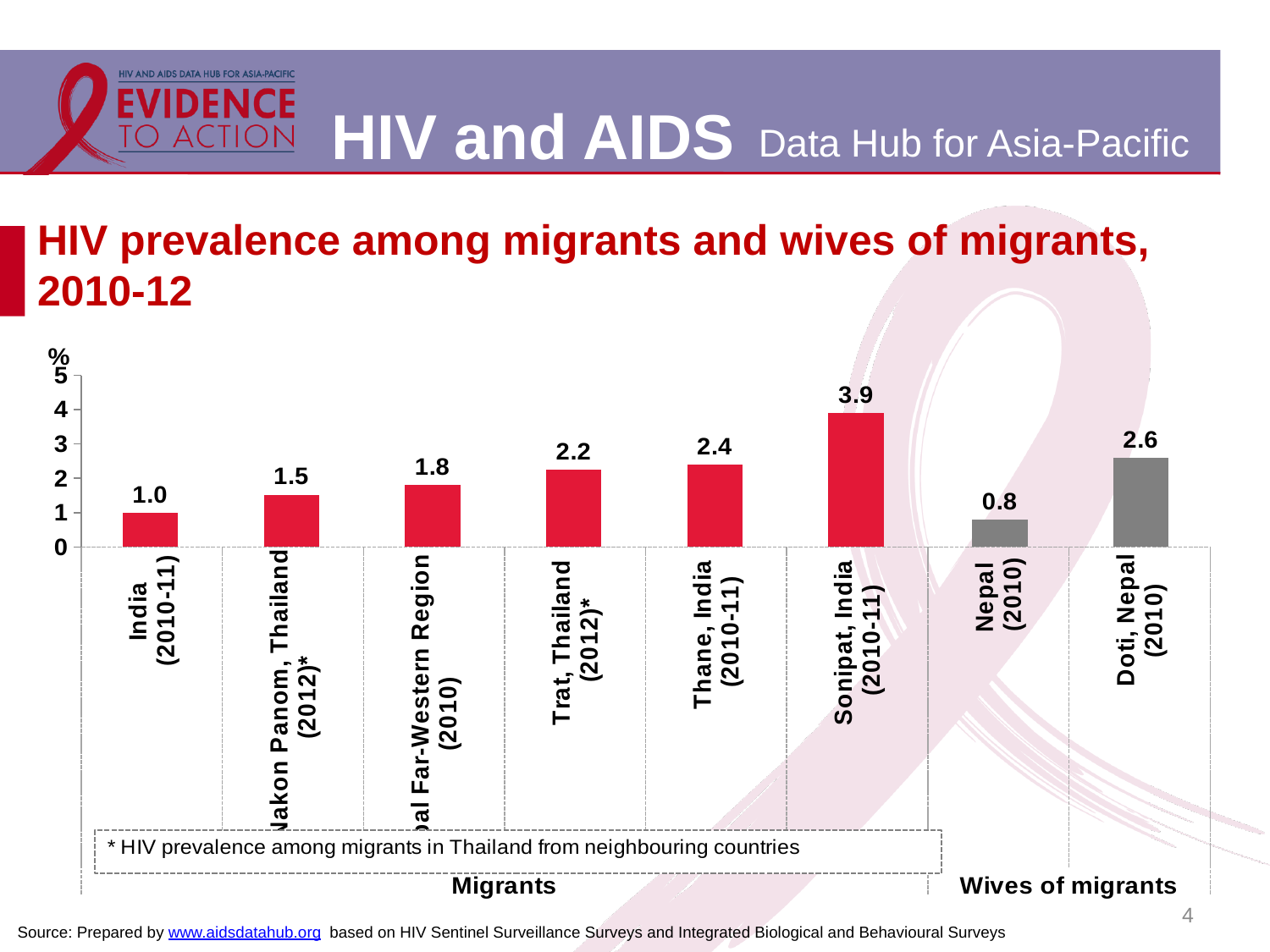
How many bars are plotted on the chart? 8 Which is larger, the value for Doti, Nepal (2010) or the value for Thane, India (2010-11)? Doti, Nepal (2010) What is the difference between the values for Sonipat, India (2010-11) and Thane, India (2010-11)? 1.5 How many bars are in the 'Wives of migrants' group? 2 Is the value for Nakon Panom, Thailand (2012) greater or less than 2? less What is the HIV prevalence value shown for Sonipat, India (2010-11)? 3.9 Which category has the highest HIV prevalence on the chart? Sonipat, India (2010-11) What is the HIV prevalence value shown for Doti, Nepal (2010)? 2.6 What unit is shown on the vertical axis of the chart? % What type of chart is shown on the slide? Bar chart What is the HIV prevalence value shown for Trat, Thailand (2012)? 2.2 Which category has the lowest HIV prevalence on the chart? Nepal (2010)